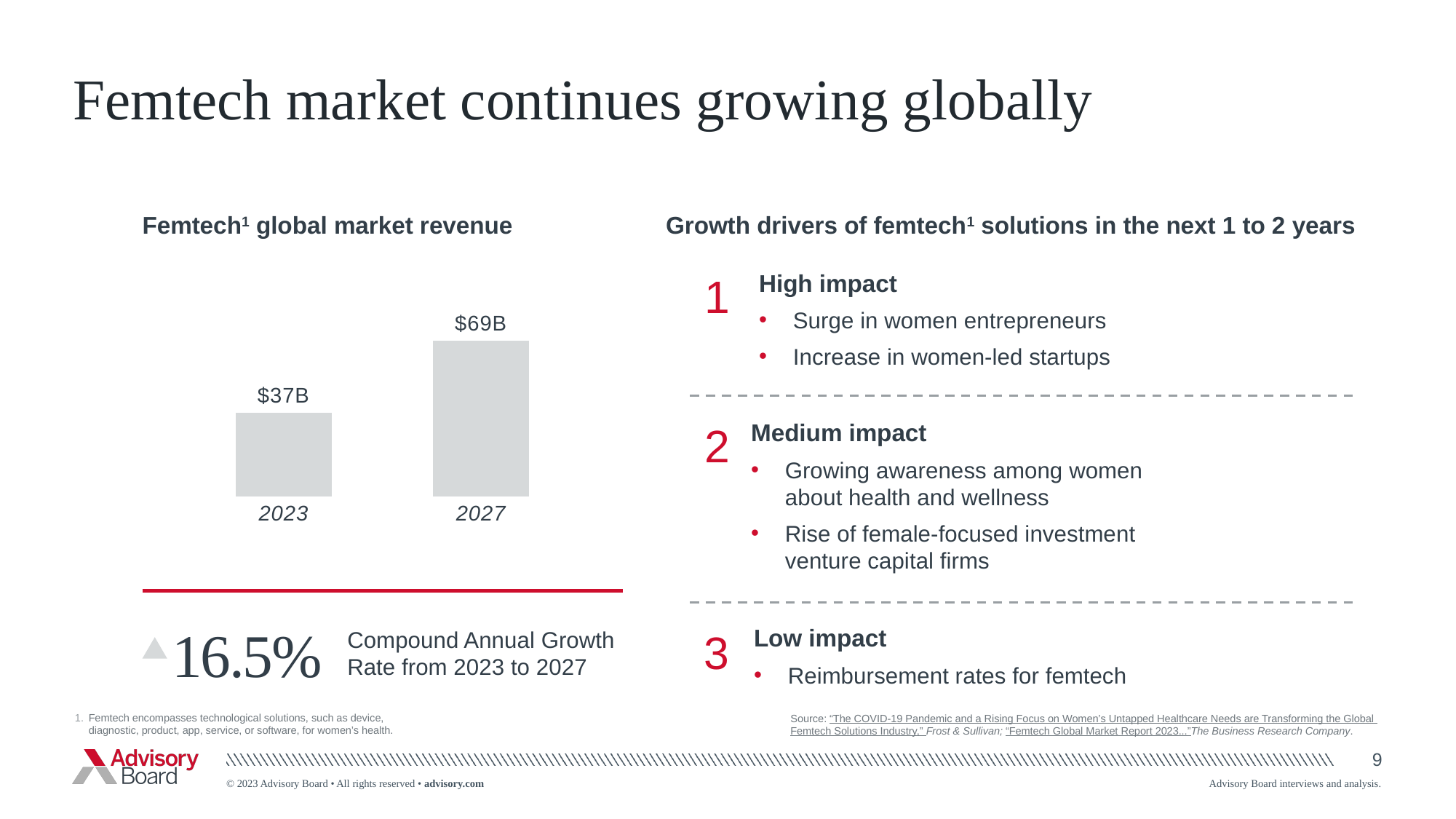
Which year has the lower femtech global market revenue? 2023 How many years are plotted in the femtech global market revenue chart? 2 What is the difference between the 2027 and 2023 femtech global market revenue values? $32B What is the femtech global market revenue shown for 2023? $37B Does femtech global market revenue rise or fall from 2023 to 2027? Rise What is the title of the chart on the left of the slide? Femtech global market revenue Is the femtech global market revenue larger in 2023 or 2027? 2027 What compound annual growth rate from 2023 to 2027 is shown below the chart? 16.5% What kind of chart is used to show femtech global market revenue? Bar chart What is the femtech global market revenue shown for 2027? $69B Which year has the higher femtech global market revenue? 2027